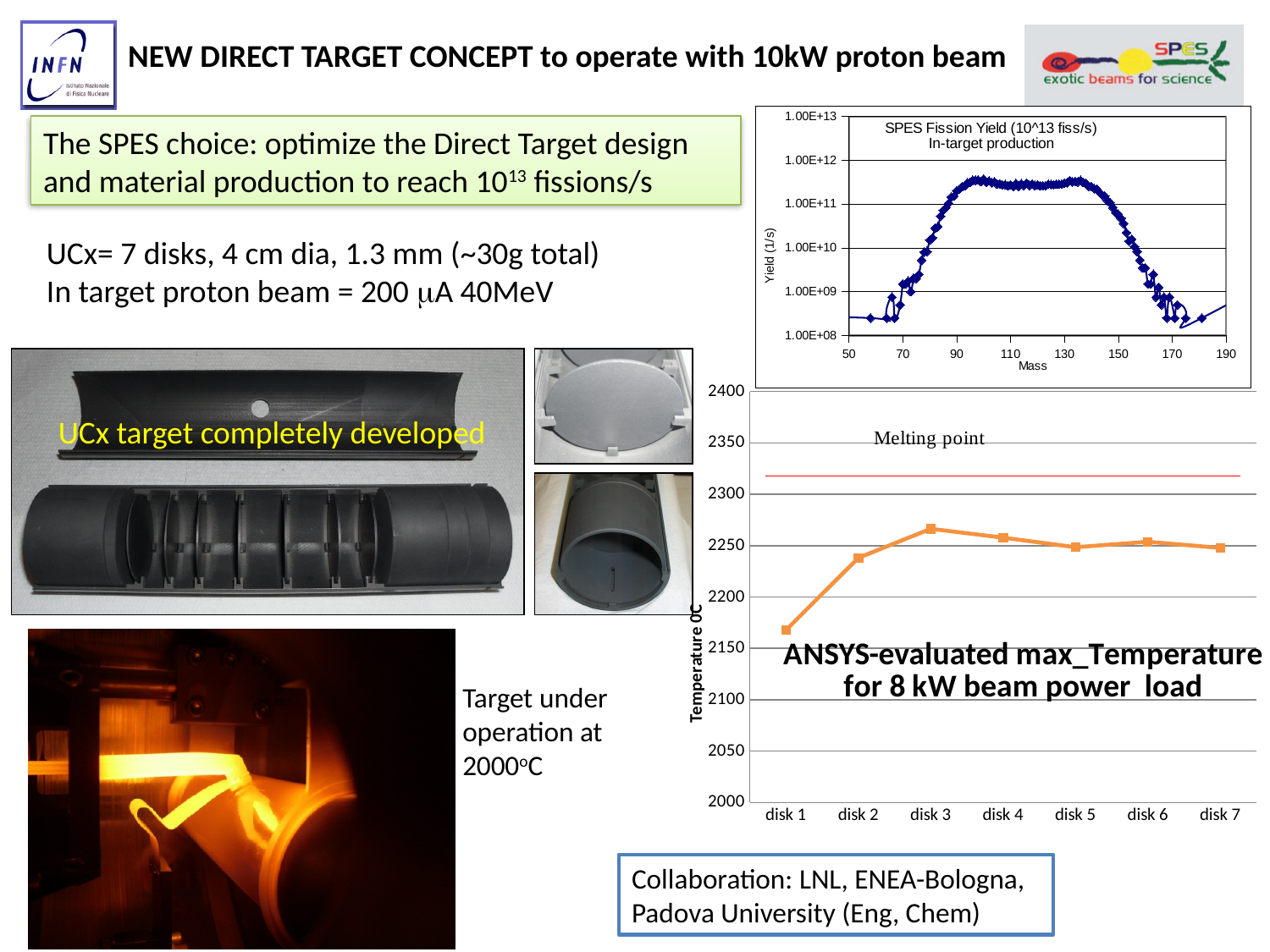
In the temperature chart at the bottom right, is the red Melting point line above or below 2300? above In the SPES Fission Yield chart, is the yield at mass 50 greater or less than 1.00E+09? less In the temperature chart at the bottom right, which disk has the highest temperature? disk 3 What is the title of the chart at the top right of the slide? SPES Fission Yield (10^13 fiss/s) In-target production In the temperature chart at the bottom right, which disk has the lowest temperature? disk 1 In the temperature chart at the bottom right, which has the higher temperature, disk 2 or disk 3? disk 3 In the temperature chart at the bottom right, is the temperature for disk 3 greater or less than 2250? greater In the SPES Fission Yield chart, is the yield at mass 110 greater or less than 1.00E+11? greater In the temperature chart at the bottom right, does the temperature rise or fall from disk 1 to disk 3? rise In the temperature chart at the bottom right, how many disks are shown on the x axis? 7